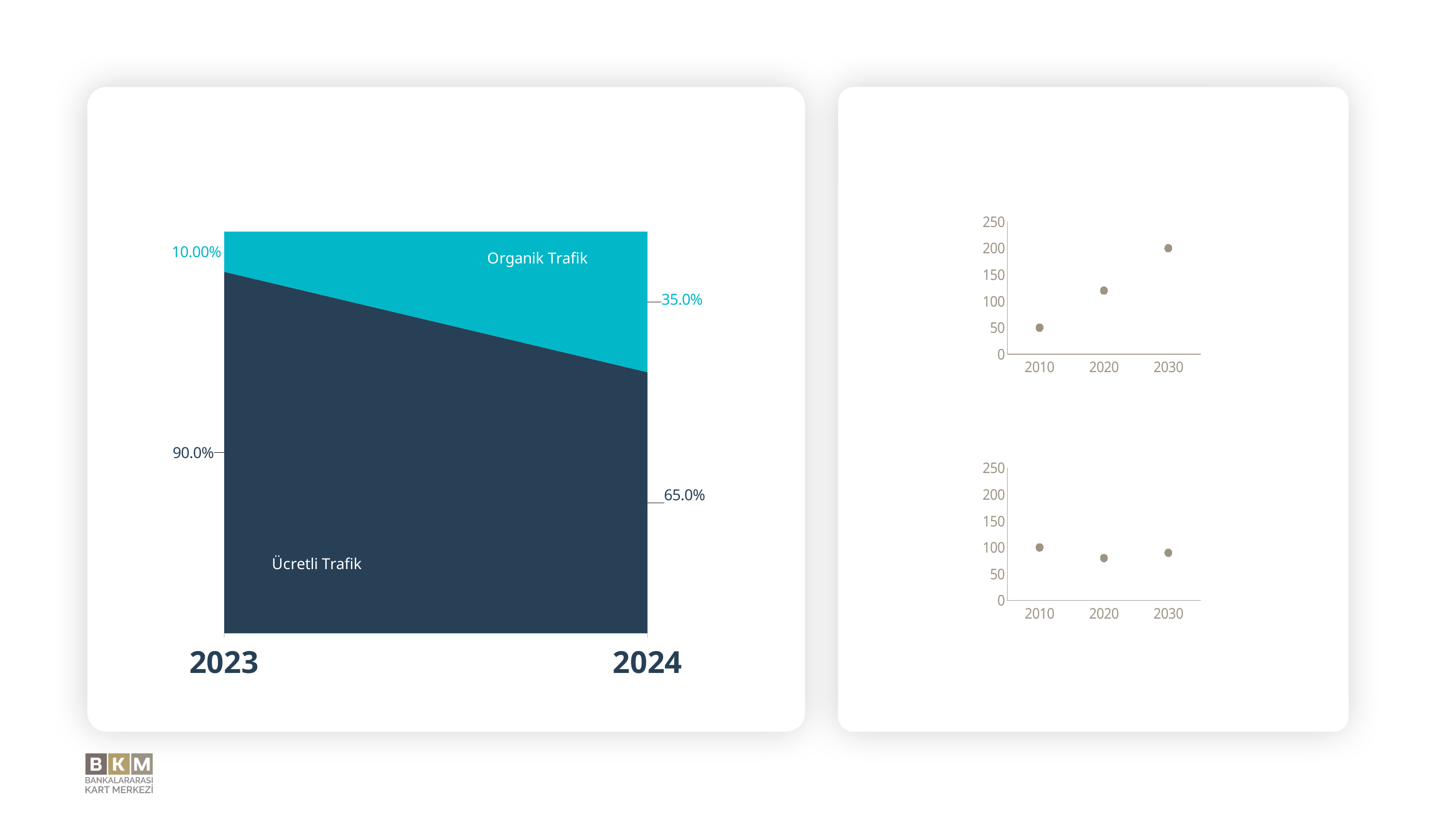
On the left chart, what is the value for Organik Trafik in 2023? 10.00% On the left chart, what is the value for Ücretli Trafik in 2024? 65.0% On the bottom right chart, which year has the highest value? 2010 On the left chart, which series is larger in 2024, Organik Trafik or Ücretli Trafik? Ücretli Trafik On the left chart, how many series are shown? 2 On the left chart, what is the value for Organik Trafik in 2024? 35.0% On the top right chart, which year has the highest value? 2030 On the top right chart, is the value for 2020 greater or less than 100? greater On the left chart, what is the difference between Ücretli Trafik and Organik Trafik in 2024? 30.0% On the left chart, what is the value for Ücretli Trafik in 2023? 90.0% On the bottom right chart, how many data points are plotted? 3 On the left chart, does Organik Trafik rise or fall from 2023 to 2024? rise